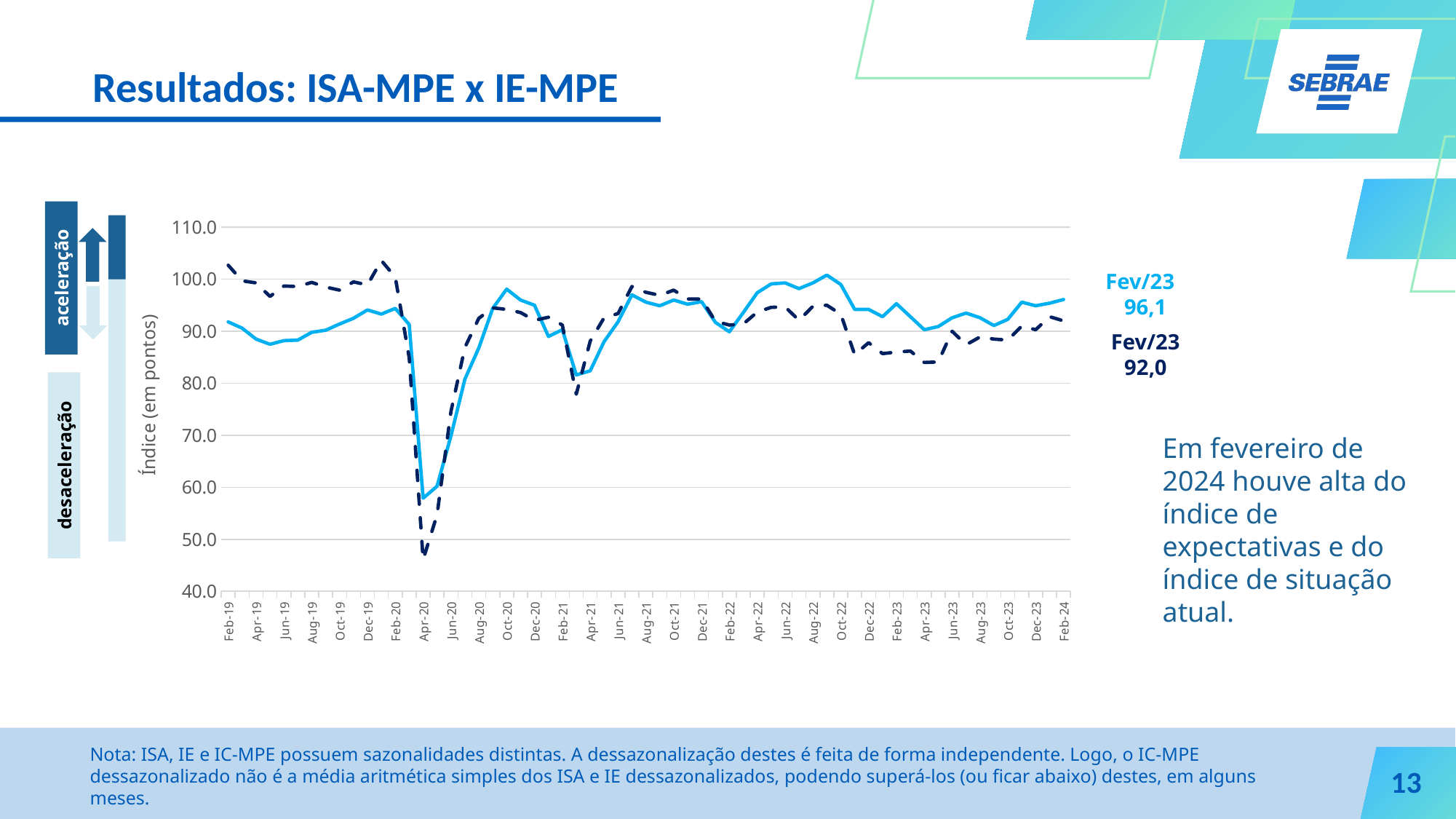
What is the difference between the two annotated values, 96,1 and 92,0? 4,1 What value is printed in the light blue annotation labelled Fev/23 next to the chart? 96,1 Which annotated value is larger, the light blue one or the dark blue one? the light blue one (96,1) How many data series (lines) are plotted on the chart? 2 Does the solid light blue line rise or fall between Feb-20 and Apr-20? falls At which x-axis label does the solid light blue line reach its lowest point? Apr-20 What kind of chart is shown on the slide? line chart Is the value of the solid light blue line at Apr-20 greater or less than 70? less Is the value of the dashed dark blue line at Feb-19 greater or less than 100? greater Is the value of the dashed dark blue line at Apr-20 greater or less than 50? less What is the title of the vertical axis of the chart? Índice (em pontos) What value is printed in the dark blue annotation labelled Fev/23 next to the chart? 92,0